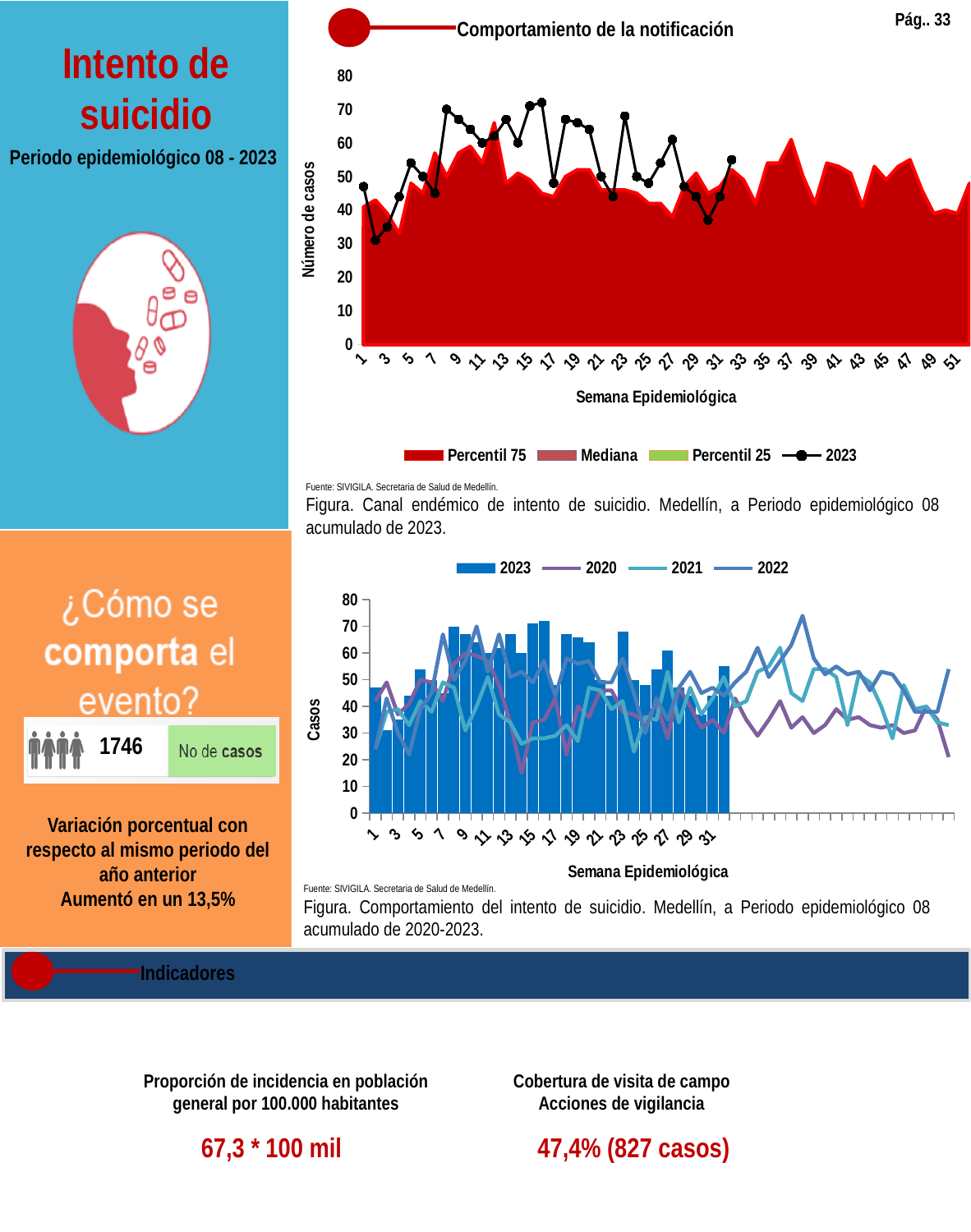
In the top chart 'Comportamiento de la notificación', which legend entry is drawn as a black line with markers? 2023 In the bottom chart, is the 2023 value for week 16 greater or less than 60? greater In the bottom chart, is the 2020 value for week 52 greater or less than 30? less In the top chart 'Comportamiento de la notificación', what is the label of the y axis? Número de casos In the top chart 'Comportamiento de la notificación', how many series does the legend list? 4 In the bottom chart, is the 2023 value for week 2 greater or less than 40? less In the bottom chart, how many series does the legend list? 4 In the bottom chart, which series is shown as bars rather than a line? 2023